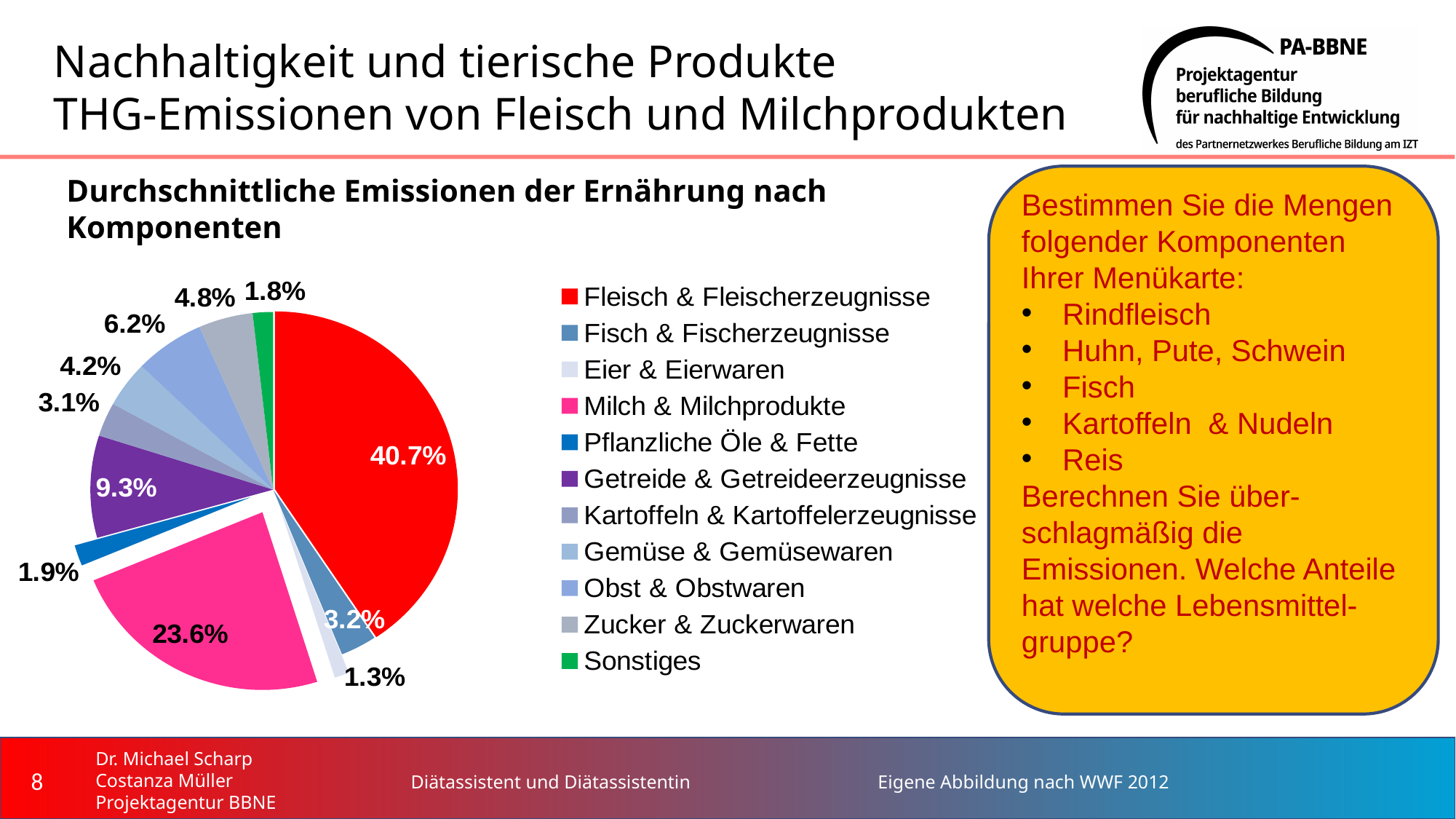
What is the value for Getreide & Getreideerzeugnisse? 9.3% What percentage is shown for Obst & Obstwaren? 6.2% Which is larger, the share for Gemüse & Gemüsewaren or the share for Zucker & Zuckerwaren? Zucker & Zuckerwaren How many categories does the pie chart show? 11 Which category has the largest share of the pie? Fleisch & Fleischerzeugnisse What is the title of the chart? Durchschnittliche Emissionen der Ernährung nach Komponenten What share of the pie does Fleisch & Fleischerzeugnisse account for? 40.7% Which colour represents Sonstiges in the legend? Green Which category has the smallest share of the pie? Eier & Eierwaren What percentage is shown for Milch & Milchprodukte? 23.6% What is the difference in percentage points between Fleisch & Fleischerzeugnisse and Milch & Milchprodukte? 17.1 What kind of chart is shown on the slide? Pie chart